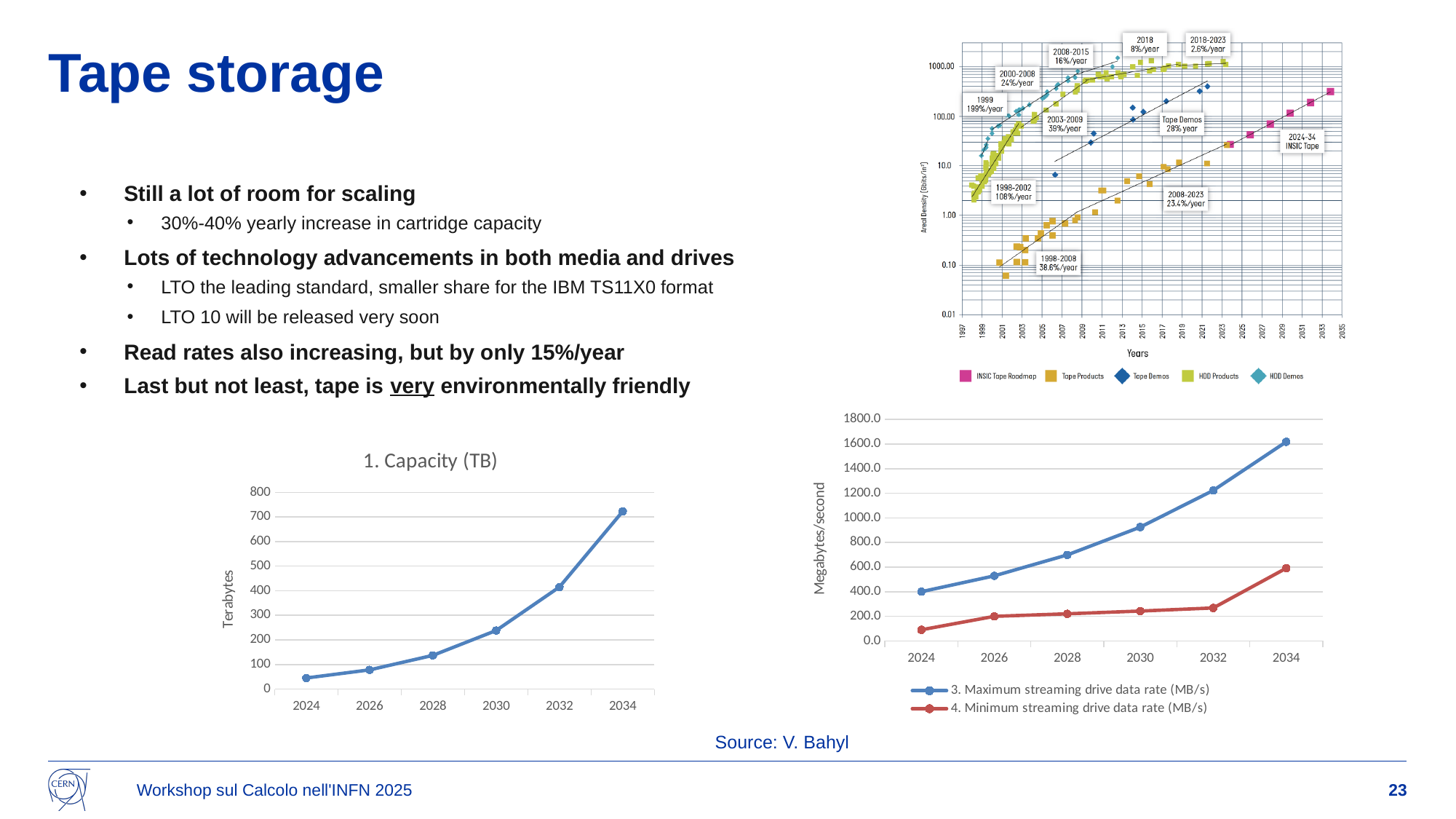
In the '1. Capacity (TB)' chart, is the value for 2034 greater or less than 600? greater In the bottom-right streaming drive data rate chart, how many series does the legend list? 2 In the '1. Capacity (TB)' chart, is the value for 2024 greater or less than 100? less In the bottom-right streaming drive data rate chart, is the value for '3. Maximum streaming drive data rate (MB/s)' in 2034 greater or less than 1400? greater In the top-right areal density chart, how many series does the legend list? 5 What kind of chart is the '1. Capacity (TB)' chart? line chart In the '1. Capacity (TB)' chart, do the values rise or fall from 2024 to 2034? rise In the '1. Capacity (TB)' chart, how many data points are plotted? 6 In the bottom-right streaming drive data rate chart, what is the y-axis label? Megabytes/second In the bottom-right streaming drive data rate chart, which series has the larger value in 2034, the maximum or the minimum streaming drive data rate? 3. Maximum streaming drive data rate (MB/s)